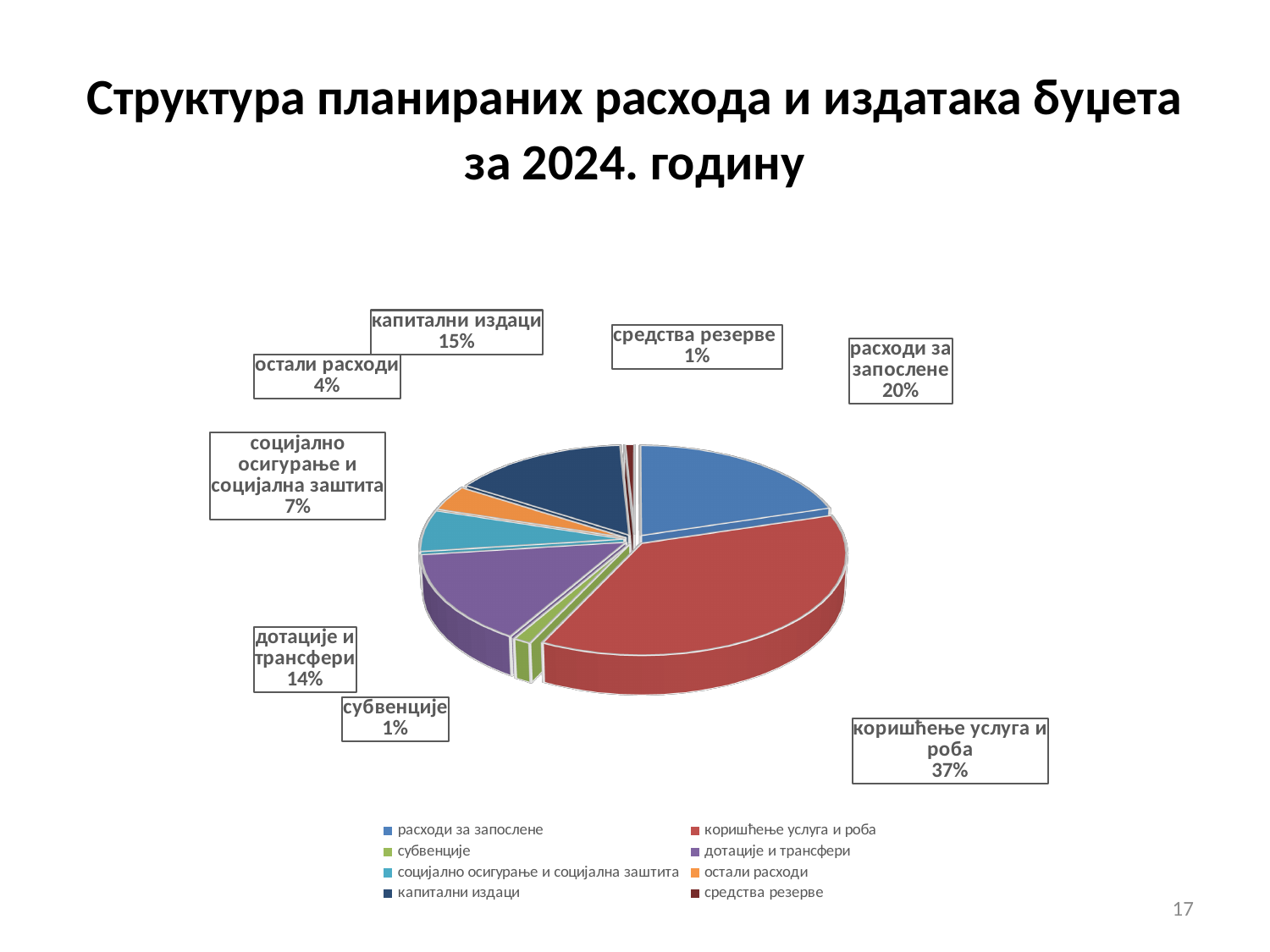
Which is larger, the share for капитални издаци or the share for дотације и трансфери? капитални издаци What percentage is shown for расходи за запослене? 20% What share of the budget is planned for коришћење услуга и роба? 37% What is the difference in percentage points between коришћење услуга и роба and расходи за запослене? 17 percentage points Which category has the largest share of the pie? коришћење услуга и роба How many categories does the pie chart have? 8 What percentage is shown for капитални издаци? 15% What percentage is shown for дотације и трансфери? 14% What share does социјално осигурање и социјална заштита have? 7% What kind of chart is shown on the slide? pie chart What is the title of the slide containing the chart? Структура планираних расхода и издатака буџета за 2024. годину What percentage is shown for остали расходи? 4%